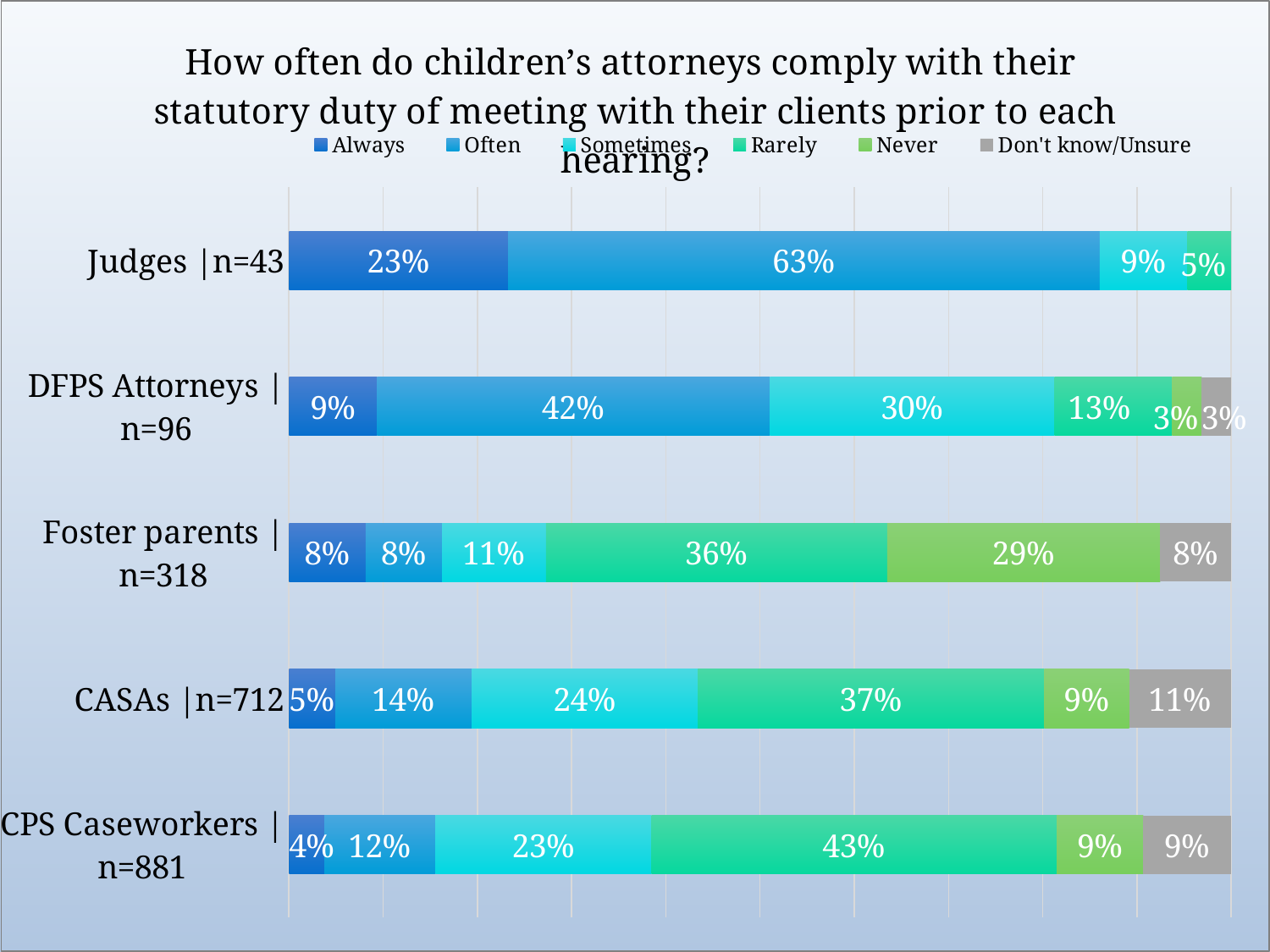
Which respondent group has the lowest "Always" percentage? CPS Caseworkers What is the difference in percentage points between the "Often" value for Judges and the "Often" value for DFPS Attorneys? 21 What percentage of Foster parents answered "Never"? 29% How many series does the legend list? 6 What is the sample size (n) shown for CASAs? 712 What percentage of CASAs answered "Don't know/Unsure"? 11% What kind of chart is shown on the slide? Stacked bar chart Which respondent group has the highest "Often" percentage? Judges What percentage of Judges answered "Often"? 63% How many respondent groups are shown in the chart? 5 Which is larger: the "Rarely" value for CASAs or the "Rarely" value for Foster parents? CASAs What percentage of CPS Caseworkers answered "Rarely"? 43%